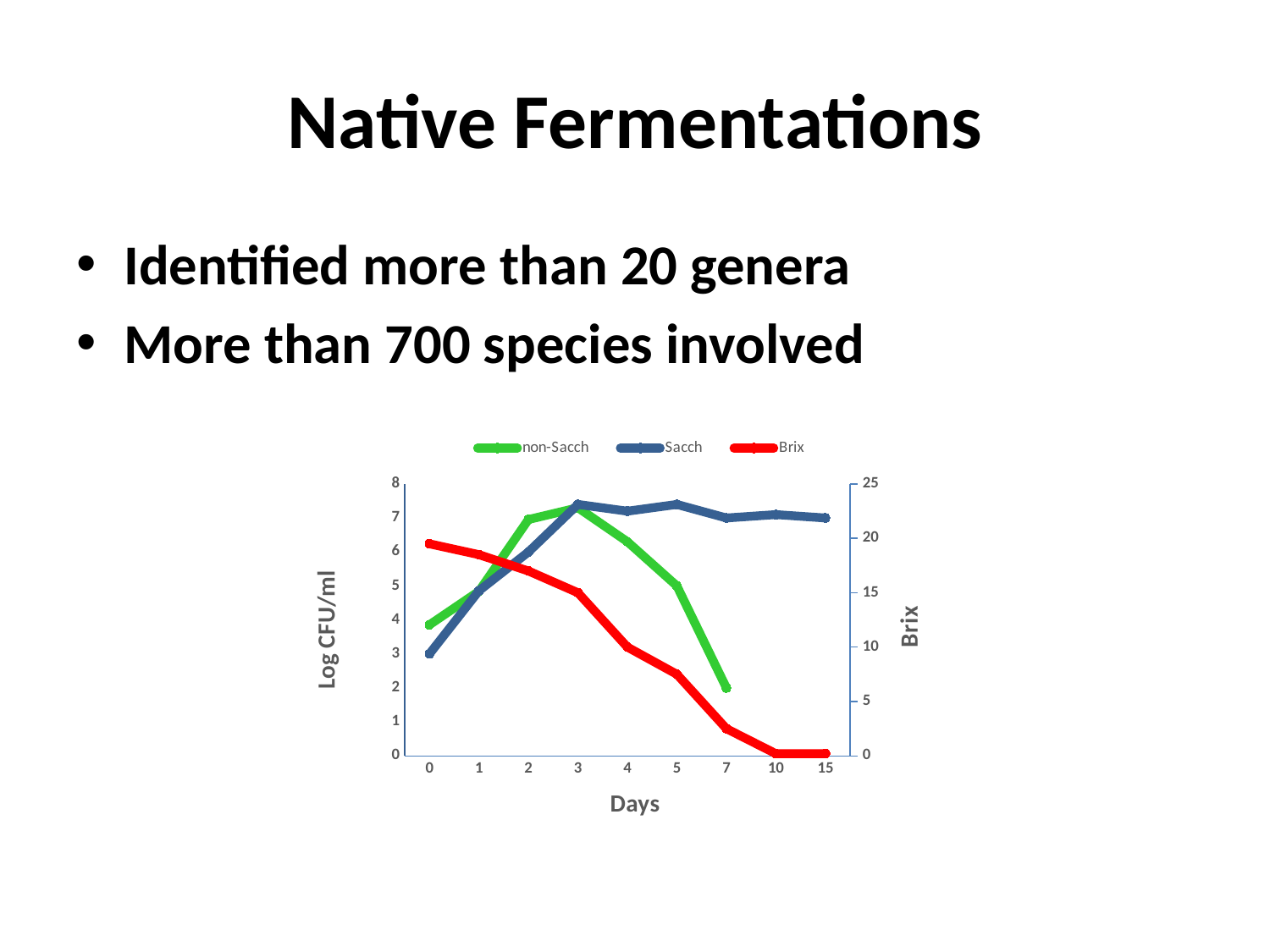
What is the title of the left vertical axis of the chart? Log CFU/ml How many series does the chart legend list? 3 Is the Sacch value at day 15 greater or less than 6 on the Log CFU/ml axis? greater At day 0, which series has the lower value on the Log CFU/ml axis, Sacch or non-Sacch? Sacch How many day values are marked along the x axis of the chart? 9 Is the Sacch value at day 0 greater or less than 4 on the Log CFU/ml axis? less What kind of chart is shown on the slide? line chart At day 7, which series has the higher value on the Log CFU/ml axis, Sacch or non-Sacch? Sacch Does the non-Sacch series rise or fall between day 3 and day 7? fall Is the non-Sacch value at day 7 greater or less than 3 on the Log CFU/ml axis? less Does the Brix series rise or fall as the days increase? fall